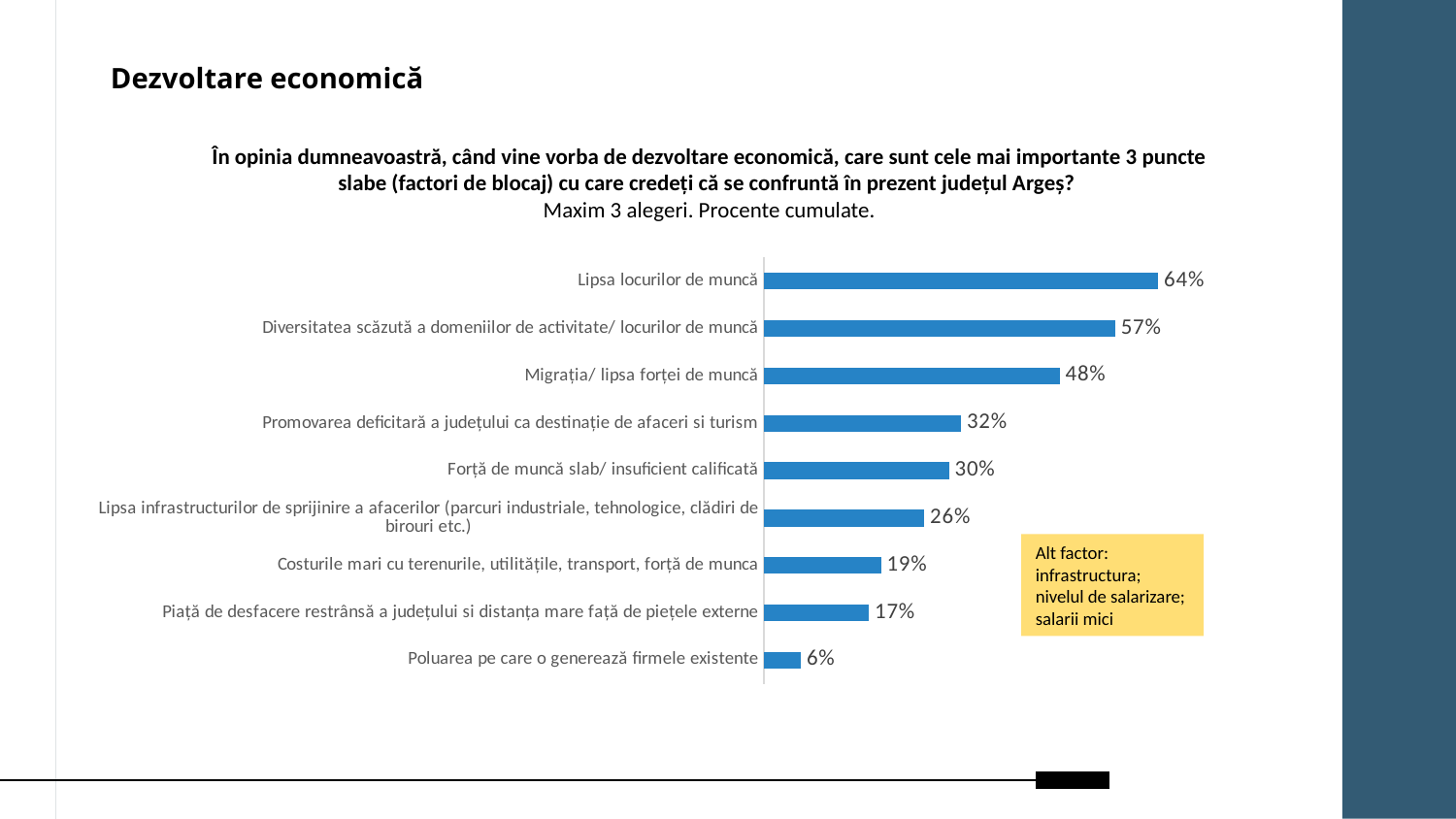
What kind of chart is shown on the slide? Bar chart Which category has the highest value? Lipsa locurilor de muncă What is the difference between "Lipsa locurilor de muncă" and "Diversitatea scăzută a domeniilor de activitate/ locurilor de muncă"? 7% What colour are the bars in the chart? Blue Which category has the lowest value? Poluarea pe care o generează firmele existente What is the value for "Costurile mari cu terenurile, utilitățile, transport, forță de munca"? 19% How many categories are shown in the chart? 9 Which is larger: "Promovarea deficitară a județului ca destinație de afaceri si turism" or "Forță de muncă slab/ insuficient calificată"? Promovarea deficitară a județului ca destinație de afaceri si turism What is the value for "Lipsa locurilor de muncă"? 64% What is the value for "Poluarea pe care o generează firmele existente"? 6% What is the value for "Migrația/ lipsa forței de muncă"? 48% What is the difference between "Piață de desfacere restrânsă a județului si distanța mare față de piețele externe" and "Poluarea pe care o generează firmele existente"? 11%